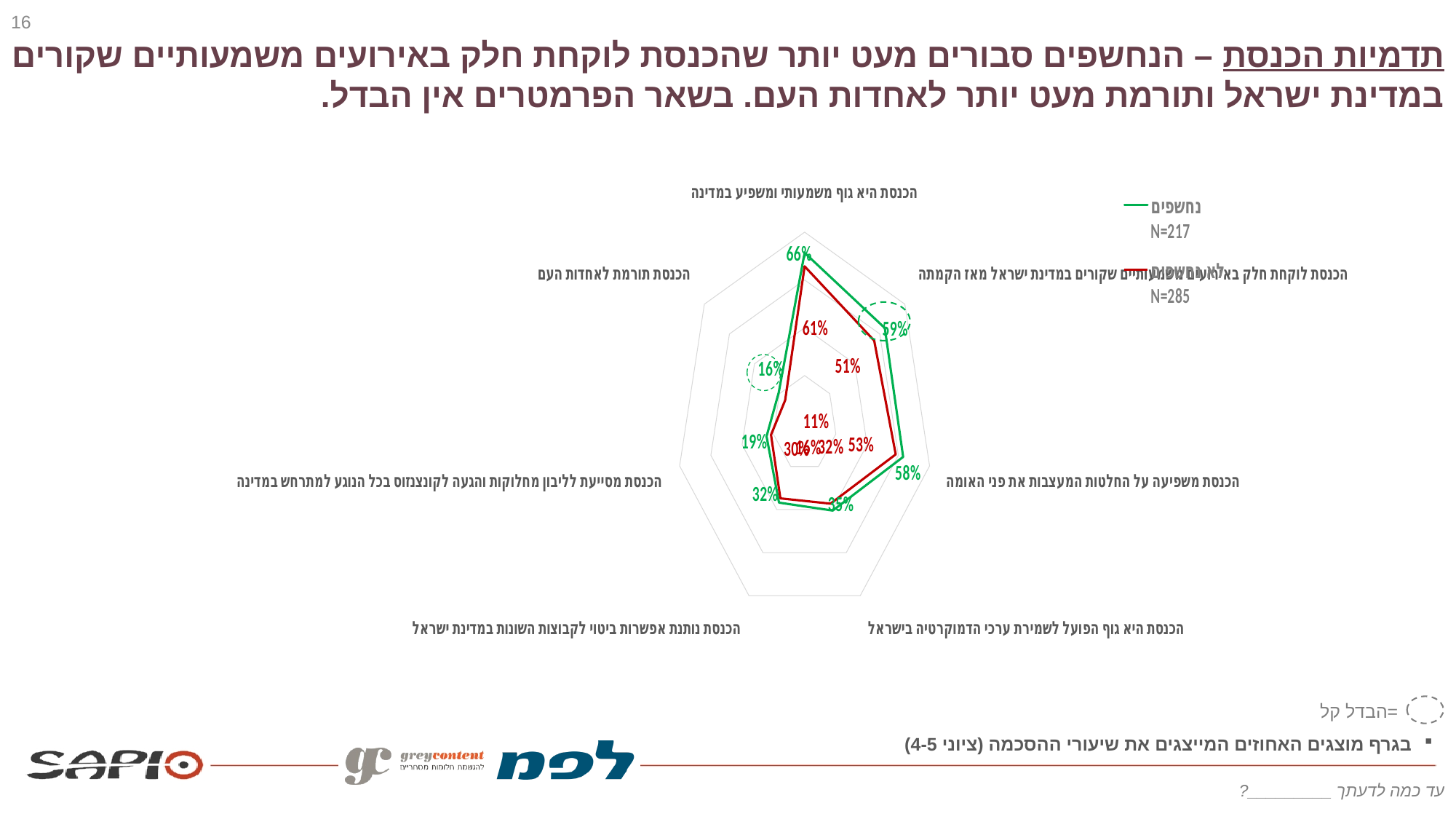
How many categories (axes) does the radar chart have? 7 What is the difference between נחשפים and לא נחשפים on the axis 'הכנסת לוקחת חלק באירועים משמעותיים שקורים במדינת ישראל מאז הקמתה'? 8 percentage points What is the value for נחשפים on the axis 'הכנסת היא גוף משמעותי ומשפיע במדינה'? 66% How many series does the chart's legend list? 2 What is the value for לא נחשפים on the axis 'הכנסת היא גוף משמעותי ומשפיע במדינה'? 61% What is the value for נחשפים on the axis 'הכנסת תורמת לאחדות העם'? 16% What sample size (N) does the legend give for the נחשפים series? N=217 What kind of chart is shown on the slide? radar chart On which axis does the נחשפים series have its lowest value? הכנסת תורמת לאחדות העם What is the value for נחשפים on the axis 'הכנסת משפיעה על החלטות המעצבות את פני האומה'? 58% What is the value for נחשפים on the axis 'הכנסת לוקחת חלק באירועים משמעותיים שקורים במדינת ישראל מאז הקמתה'? 59% On which axis does the נחשפים series reach its highest value? הכנסת היא גוף משמעותי ומשפיע במדינה